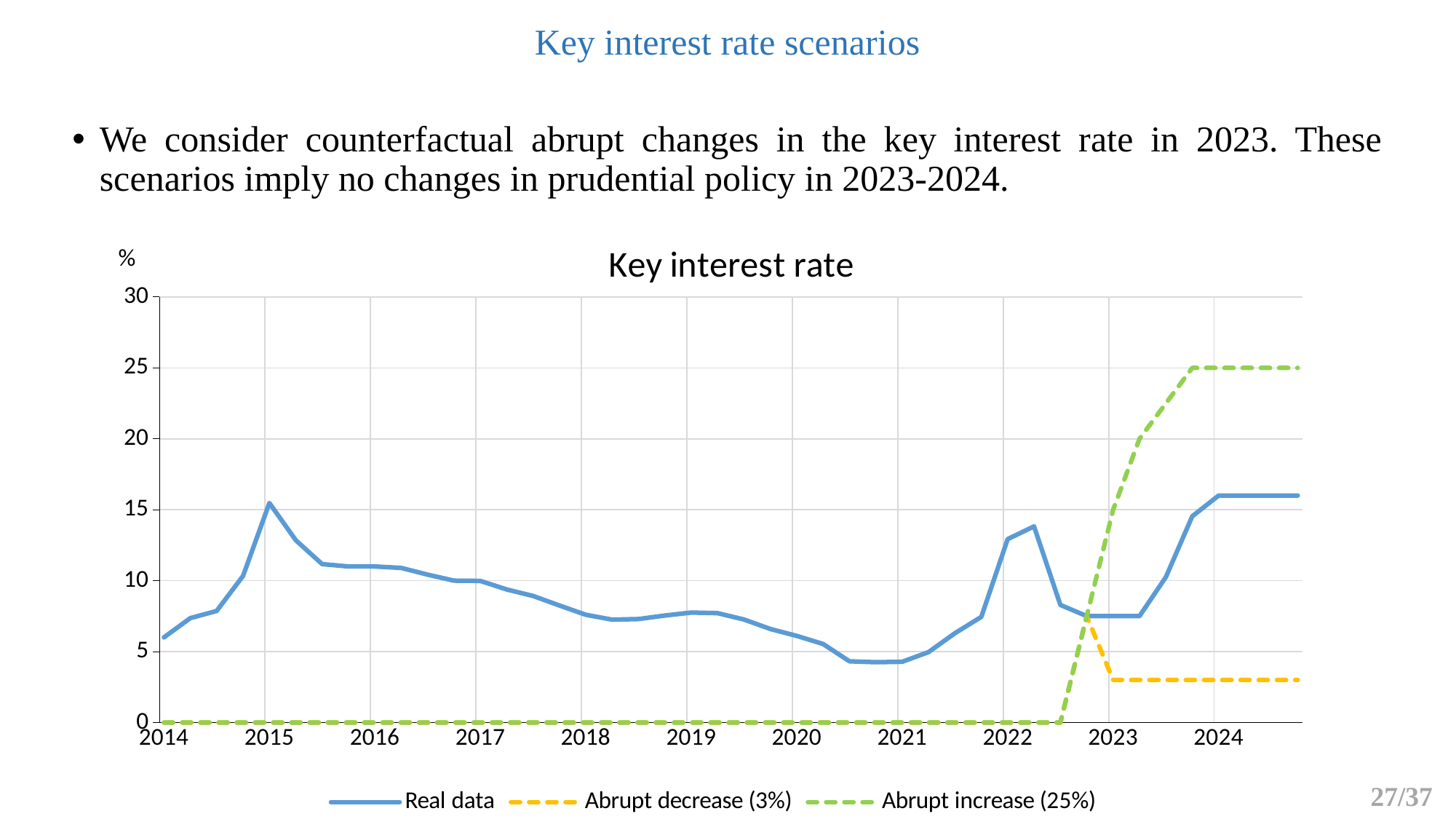
Is the Abrupt decrease (3%) scenario value in 2024 greater or less than 5? less In 2024, which is larger: the Abrupt increase (25%) scenario or the Real data? Abrupt increase (25%) What is the title of the chart? Key interest rate At what level does the Abrupt increase (25%) scenario line plateau in 2024? 25 How many series does the legend of the Key interest rate chart list? 3 Which series in the legend is drawn as a solid blue line? Real data How many year labels are shown on the x axis? 11 Is the Real data value at the start of 2014 greater or less than 5? greater Does the Real data line rise or fall between 2015 and 2020? fall What kind of chart is shown on the slide? line chart Is the Real data value in 2024 greater or less than 15? greater